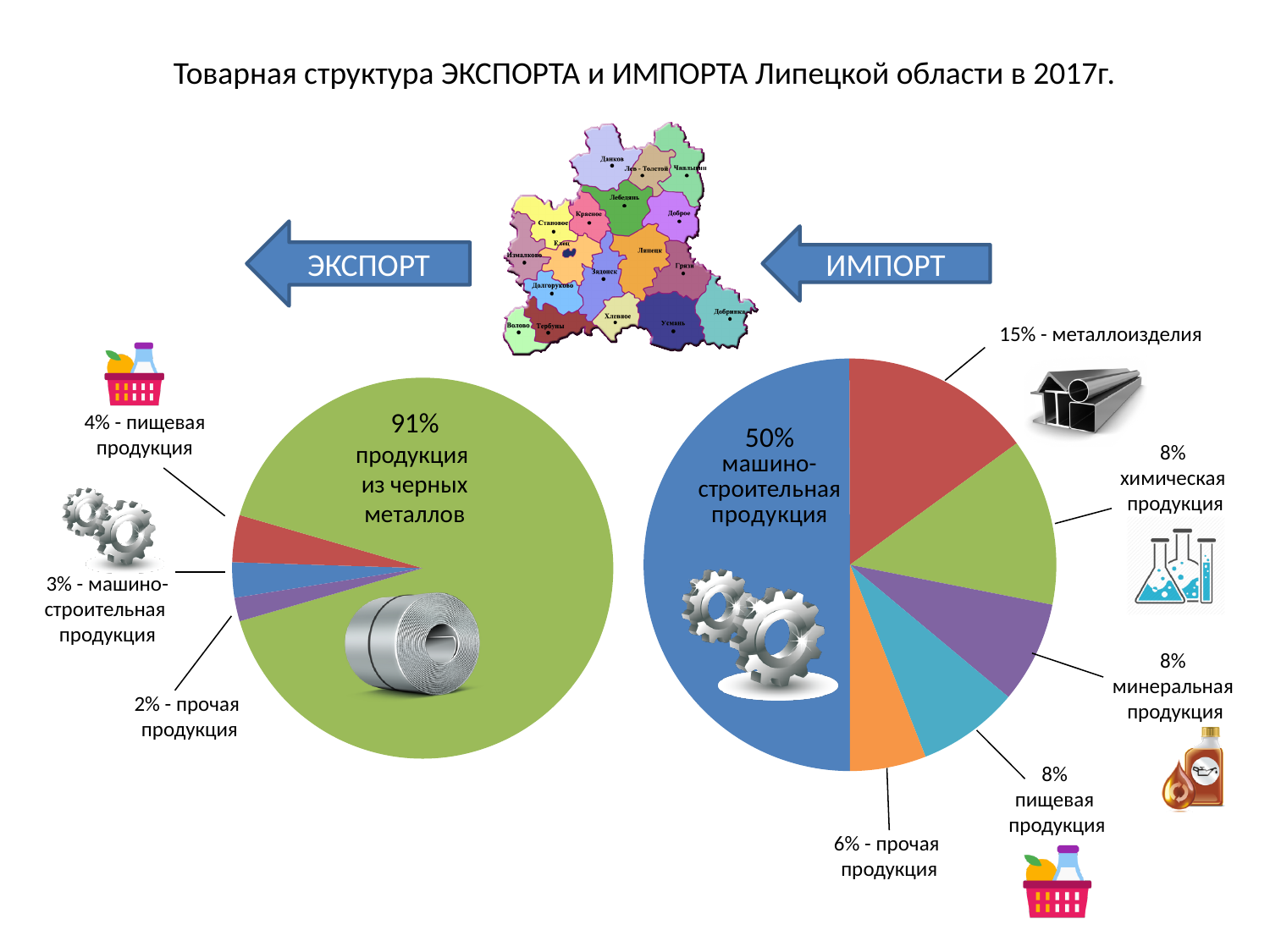
What type of chart is used for the export (ЭКСПОРТ) structure on the left? Pie chart In the import (ИМПОРТ) pie chart on the right, what share is machine-building products (машиностроительная продукция)? 50% Which is larger: the share of food products in the export pie chart or the share of food products in the import pie chart? Import (8% vs 4%) In the export (ЭКСПОРТ) pie chart on the left, what share is food products (пищевая продукция)? 4% In the export (ЭКСПОРТ) pie chart on the left, what share is products from ferrous metals (продукция из черных металлов)? 91% In the export (ЭКСПОРТ) pie chart on the left, which category has the smallest share? Прочая продукция (other products), 2% In the import (ИМПОРТ) pie chart on the right, what is the difference between the share of machine-building products and the share of metal products? 35 percentage points In the import (ИМПОРТ) pie chart on the right, which category has the largest share? Машиностроительная продукция (machine-building products), 50% How many slices does the import (ИМПОРТ) pie chart on the right have? 6 What is the title of the slide containing the two pie charts? Товарная структура ЭКСПОРТА и ИМПОРТА Липецкой области в 2017г. In the import (ИМПОРТ) pie chart on the right, what share is metal products (металлоизделия)? 15% How many slices does the export (ЭКСПОРТ) pie chart on the left have? 4